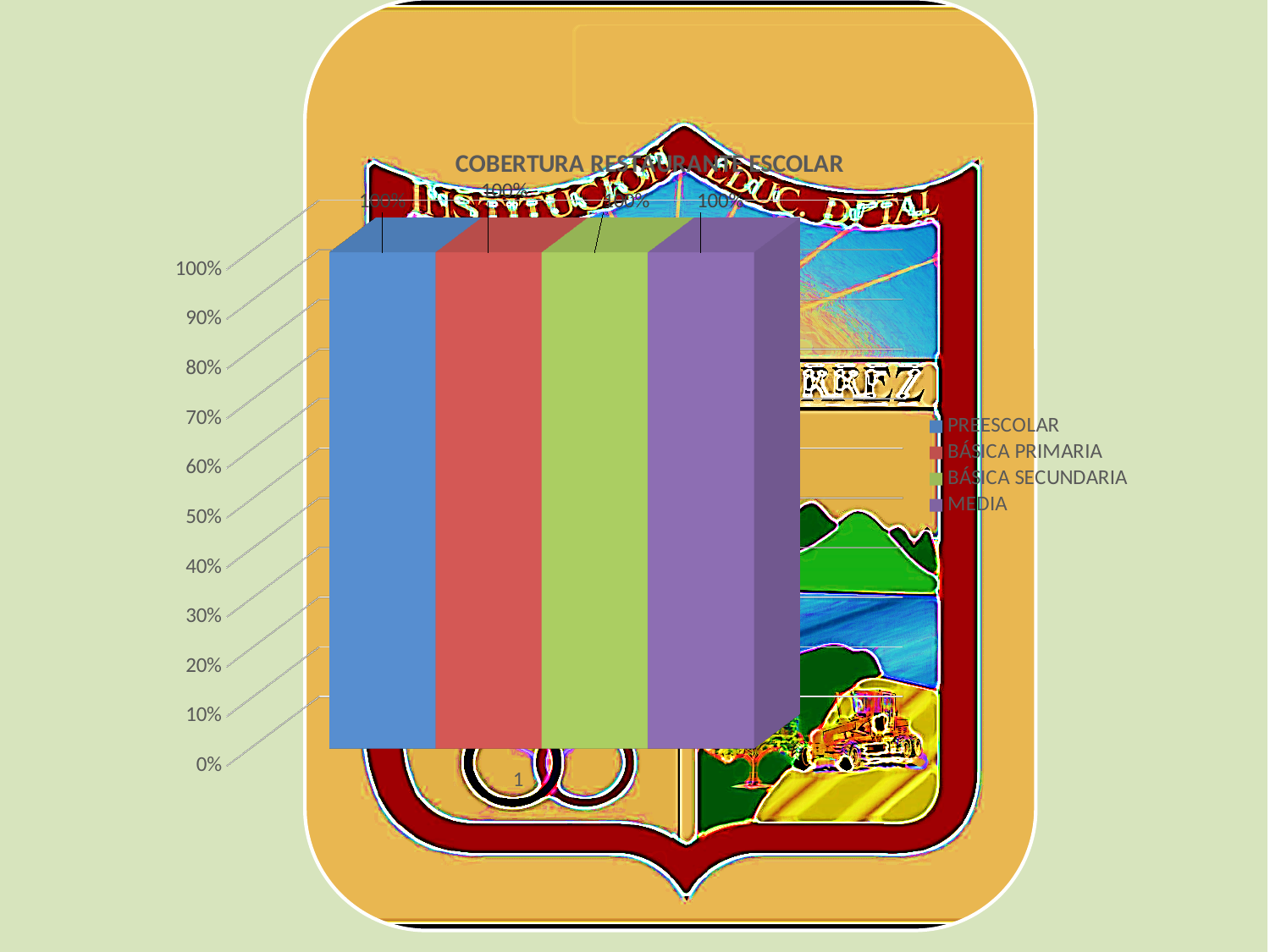
What is the value for MEDIA? 100% What is the value for PREESCOLAR? 100% Is the value for BÁSICA SECUNDARIA greater or less than 50%? greater What type of chart is shown on the slide? bar chart What is the difference between the values for PREESCOLAR and MEDIA? 0% How many categories are shown on the x axis? 1 How many series does the legend list? 4 What is the value for BÁSICA PRIMARIA? 100% What is the highest value shown on the vertical axis? 100% Which series is shown in purple in the legend? MEDIA What is the value for BÁSICA SECUNDARIA? 100% What is the title of the chart? COBERTURA RESTAURANTE ESCOLAR